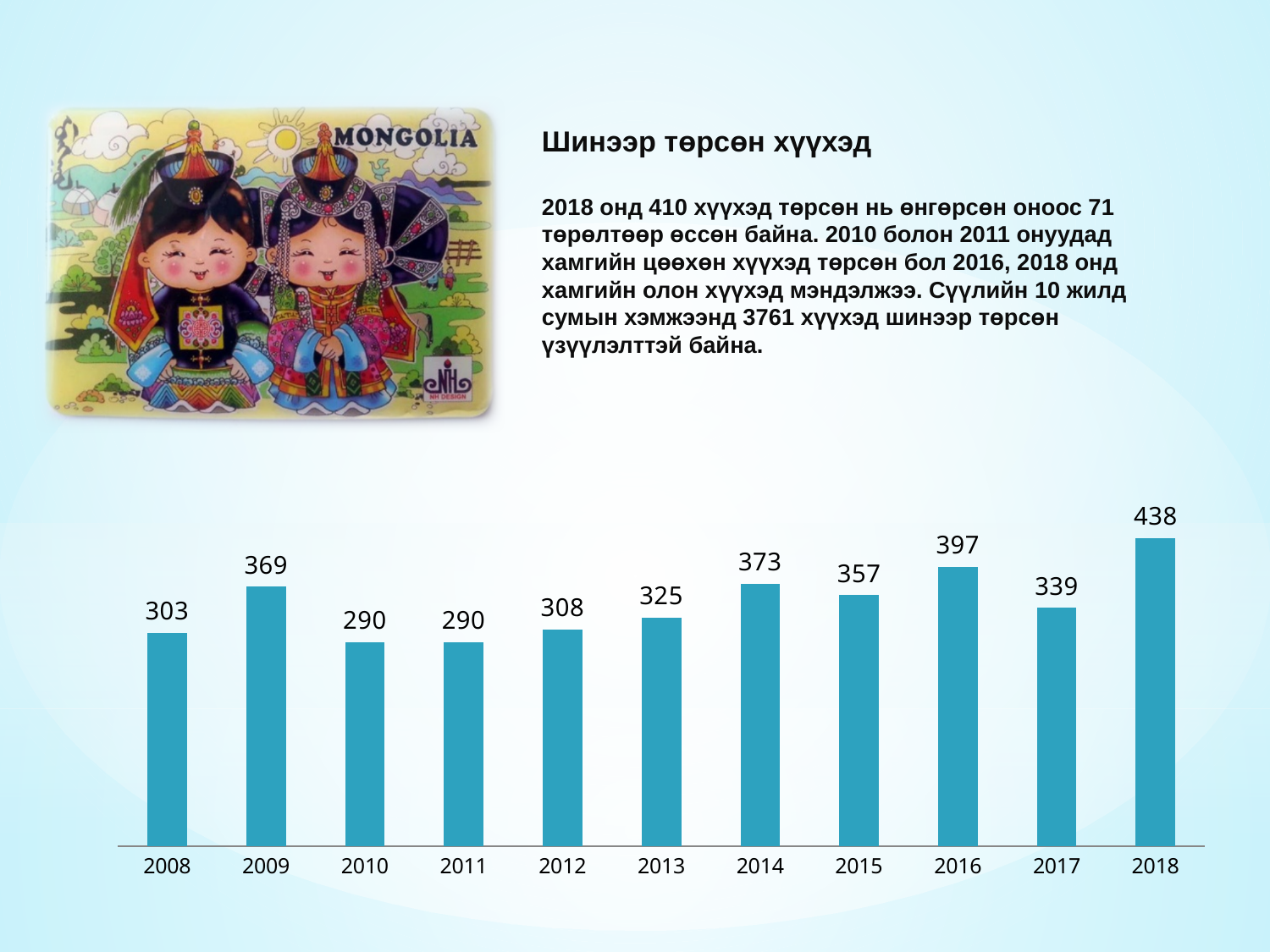
What is the difference between the values for 2016 and 2015? 40 Which is larger, the value for 2013 or the value for 2012? 2013 What is the difference between the values for 2018 and 2017? 99 What is the value for 2014? 373 What is the value for 2018? 438 Which year has the highest value? 2018 Which is larger, the value for 2009 or the value for 2015? 2009 Which years share the lowest value? 2010 and 2011 How many years are shown on the x axis? 11 What kind of chart is shown on the slide? Bar chart Does the value rise or fall from 2016 to 2017? Fall What is the value for 2009? 369